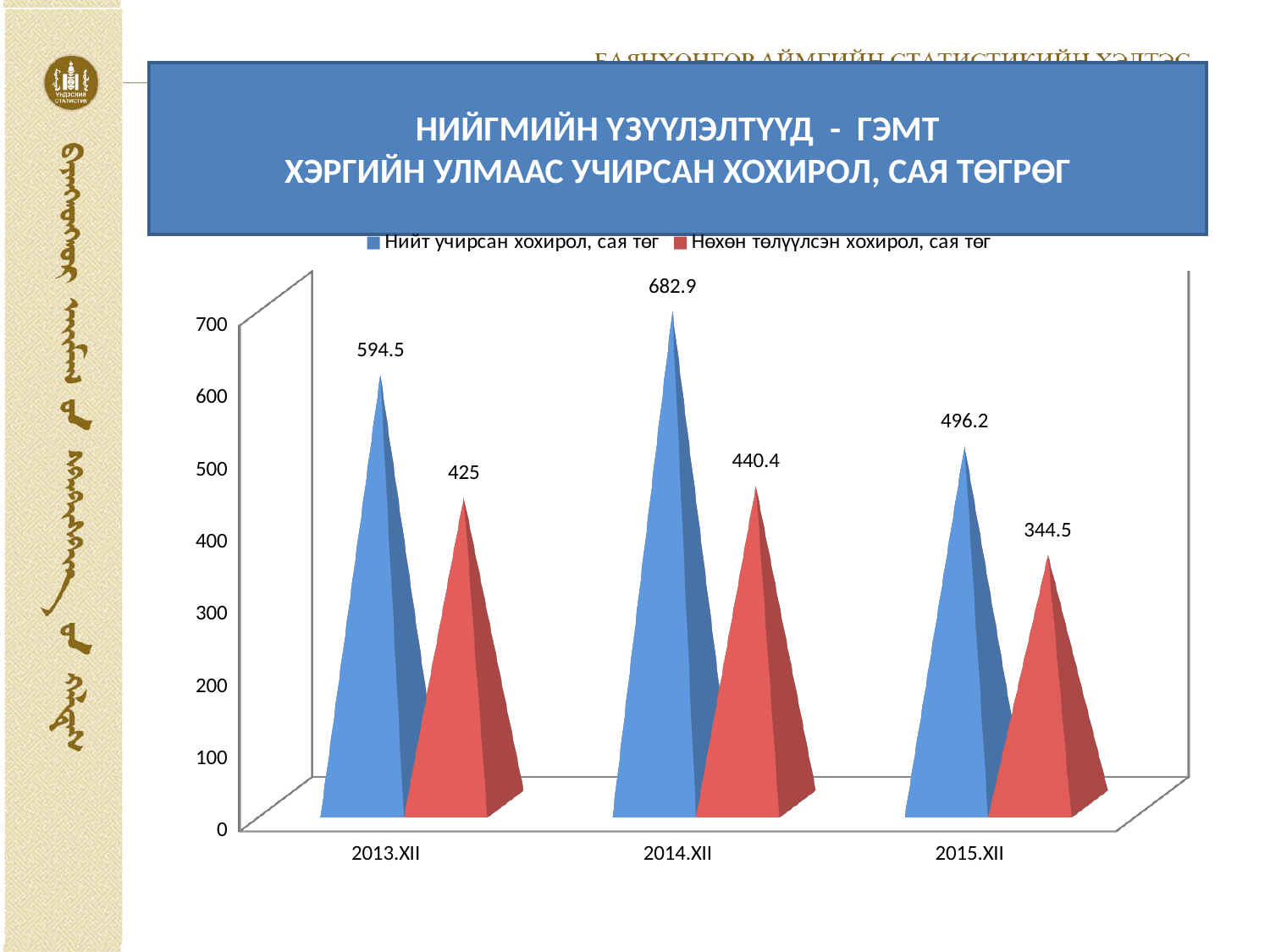
In which period is Нөхөн төлүүлсэн хохирол, сая төг lowest? 2015.XII How many series does the legend list? 2 Which is larger: Нөхөн төлүүлсэн хохирол in 2013.XII or in 2014.XII? 2014.XII What is the value of Нөхөн төлүүлсэн хохирол, сая төг for 2015.XII? 344.5 Does Нийт учирсан хохирол, сая төг rise or fall from 2014.XII to 2015.XII? fall What is the difference between Нийт учирсан хохирол and Нөхөн төлүүлсэн хохирол in 2014.XII? 242.5 What is the value of Нийт учирсан хохирол, сая төг for 2014.XII? 682.9 What is the difference between Нийт учирсан хохирол in 2013.XII and in 2015.XII? 98.3 How many periods are shown on the x axis? 3 In which period is Нийт учирсан хохирол, сая төг highest? 2014.XII Is the value of Нийт учирсан хохирол for 2015.XII greater or less than 500? less What is the value of Нөхөн төлүүлсэн хохирол, сая төг for 2013.XII? 425